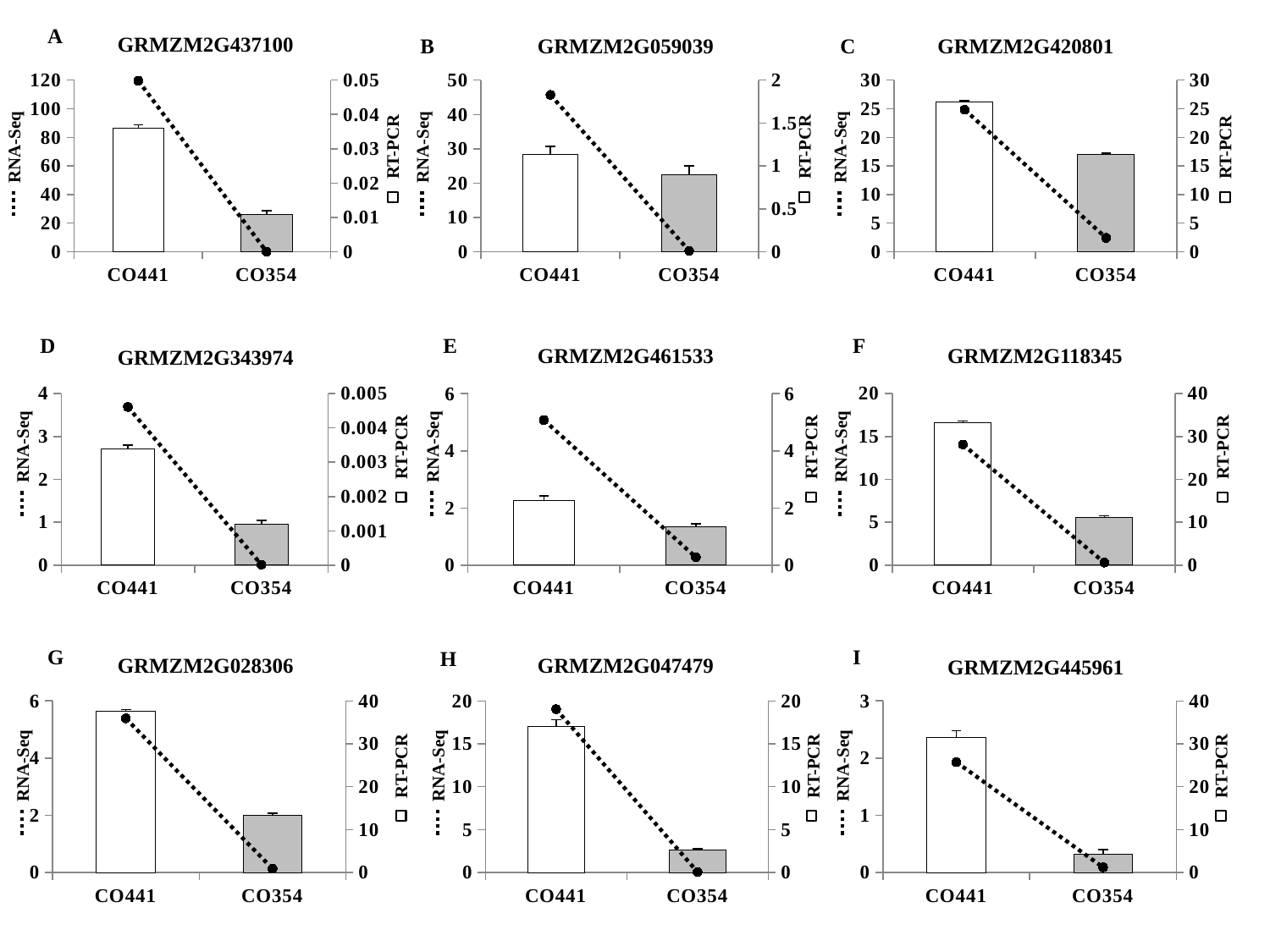
How many charts are shown on the slide? 9 In the chart titled GRMZM2G118345, is the RNA-Seq value for CO441 greater or less than 15? less How many categories are shown on the x axis of the chart titled GRMZM2G420801? 2 In the chart titled GRMZM2G343974, is the RNA-Seq value for CO441 greater or less than 2? greater In the chart titled GRMZM2G437100, is the RNA-Seq value for CO441 greater or less than 60? greater In the chart titled GRMZM2G445961, which category has the lowest RNA-Seq bar? CO354 In the chart titled GRMZM2G059039, which category has the higher RNA-Seq bar, CO441 or CO354? CO441 In the chart titled GRMZM2G461533, do the RNA-Seq bars rise or fall from CO441 to CO354? fall